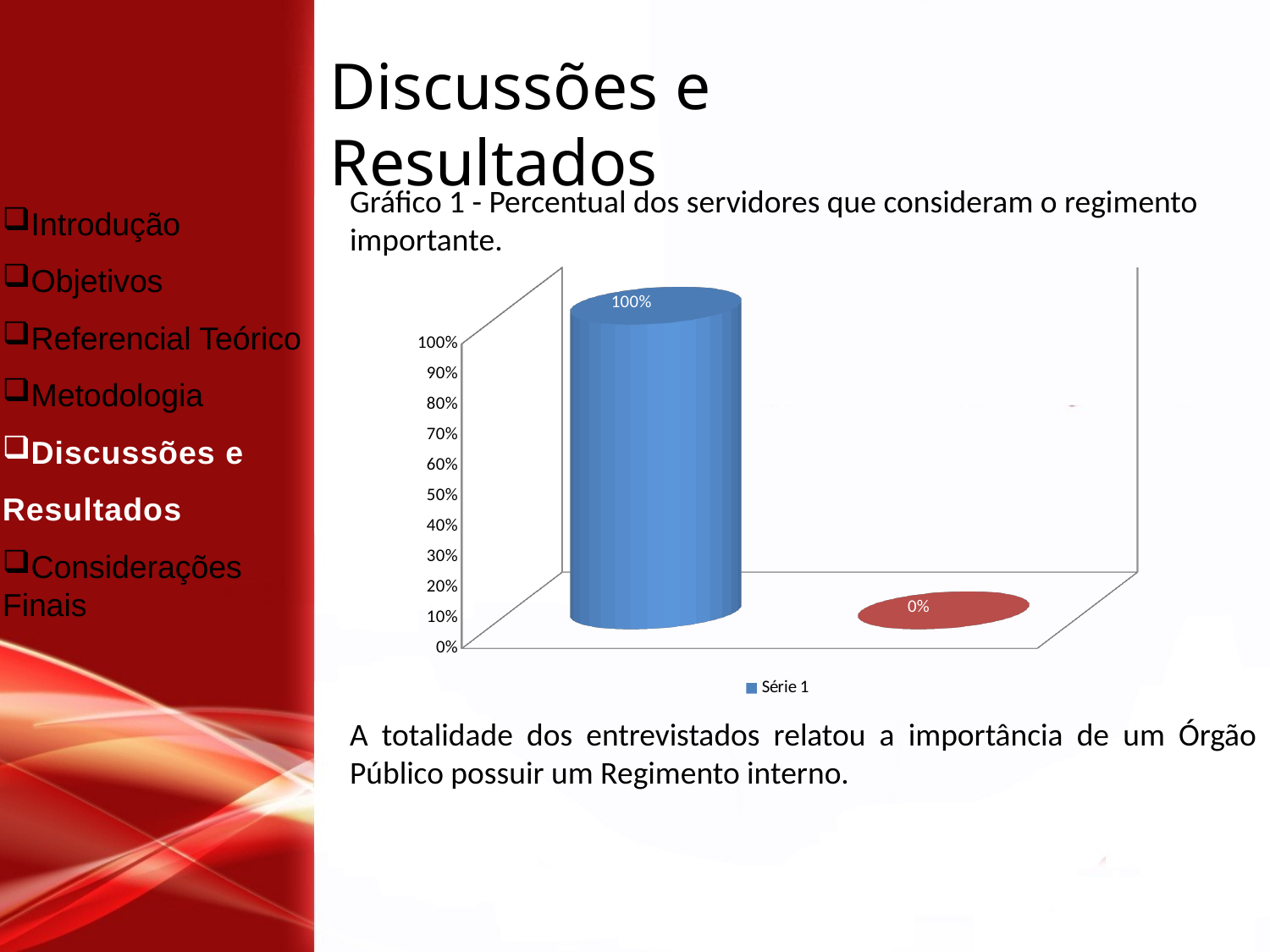
What type of chart is shown on the slide? bar chart What is the name of the series shown in the chart legend? Série 1 How many bars are plotted in the chart? 2 Is the value of the blue bar greater or less than 50%? greater What value is shown on the red bar in the chart? 0% How many series does the chart legend list? 1 Which bar has the larger value, the blue bar or the red bar? the blue bar What is the highest value shown in the chart? 100% What is the maximum value shown on the chart's vertical axis? 100% What is the difference between the blue bar's value and the red bar's value? 100% What value is shown on the blue bar in the chart? 100% What is the lowest value shown in the chart? 0%